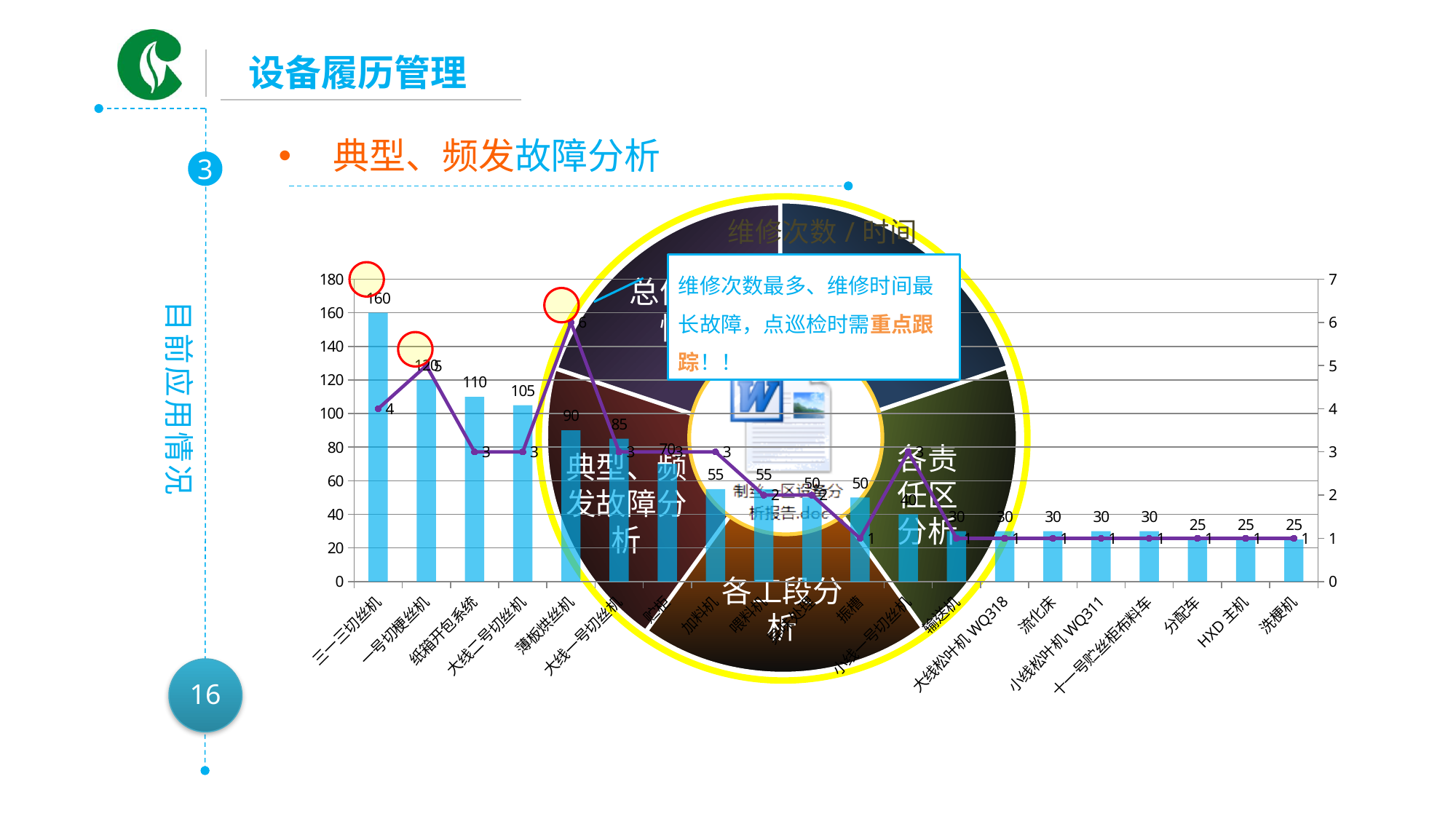
Do the bar values generally rise or fall from left to right along the x axis? fall What is the bar value for 三一三切丝机? 160 Which category has the highest line value? 薄板烘丝机 What is the bar value for 一号切梗丝机? 120 Is the bar value for 洗梗机 greater or less than 40? less What kind of chart is shown on the slide? bar chart with a line Which has the larger bar value, 纸箱开包系统 or 大线二号切丝机? 纸箱开包系统 What is the difference between the bar values for 三一三切丝机 and 一号切梗丝机? 40 What is the bar value for 薄板烘丝机? 90 What is the line value for 薄板烘丝机 on the right axis? 6 Which category has the highest bar? 三一三切丝机 What is the line value for 三一三切丝机 on the right axis? 4